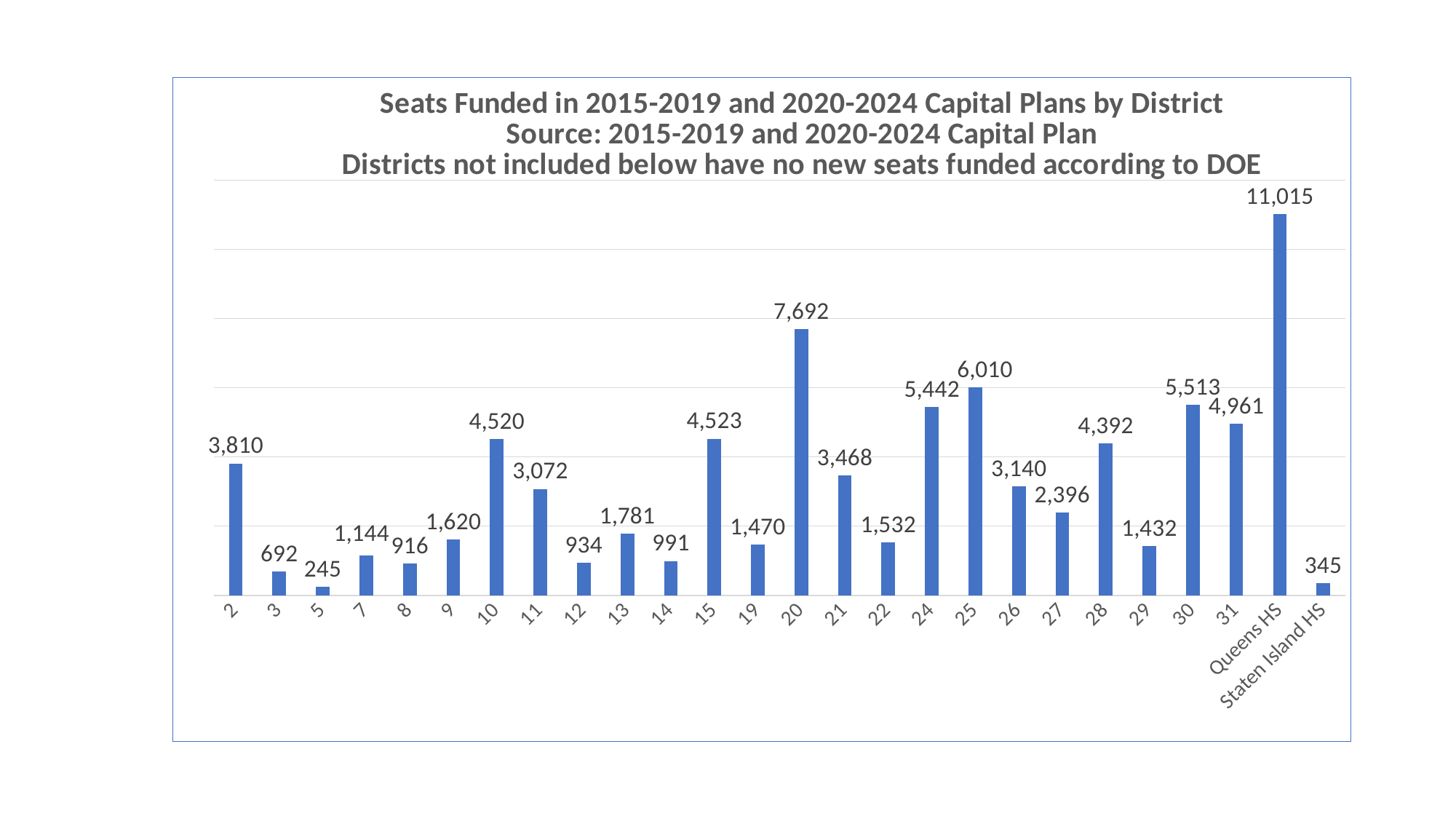
What is the title of the chart? Seats Funded in 2015-2019 and 2020-2024 Capital Plans by District What is the difference between the seats funded in District 25 and District 24? 568 How many districts or categories are shown on the x axis? 26 How many seats were funded in District 28? 4,392 What kind of chart is shown on the slide? Bar chart Which district has the lowest number of seats funded? 5 What is the difference between the seats funded for Queens HS and District 20? 3,323 Which has more seats funded, District 9 or District 13? District 13 What is the value shown for Staten Island HS? 345 How many seats were funded in District 20? 7,692 Which district or category has the highest number of seats funded? Queens HS Which has more seats funded, District 30 or District 31? District 30